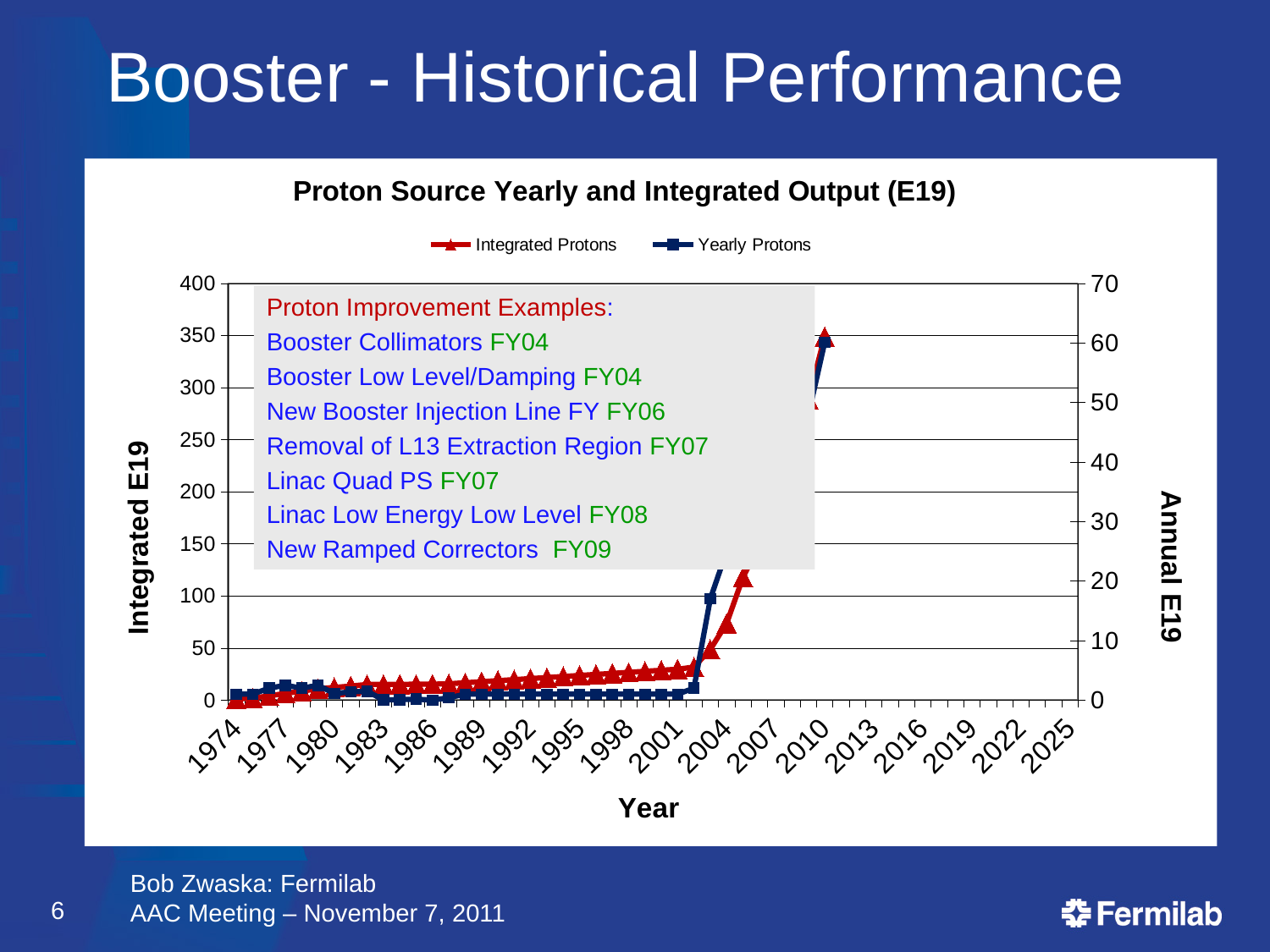
Do the Integrated Protons values rise or fall as the year increases along the x axis? Rise What is the label of the chart's x axis? Year Is the highest Integrated Protons value on the chart greater or less than 300 on the Integrated E19 axis? greater What is the title of the chart? Proton Source Yearly and Integrated Output (E19) What are the two series named in the chart's legend? Integrated Protons and Yearly Protons How many series does the chart's legend list? 2 Is the Integrated Protons value for 1998 greater or less than 50 on the Integrated E19 axis? less Is the Yearly Protons value for 1995 greater or less than 10 on the Annual E19 axis? less What kind of chart is shown on the slide? Line chart